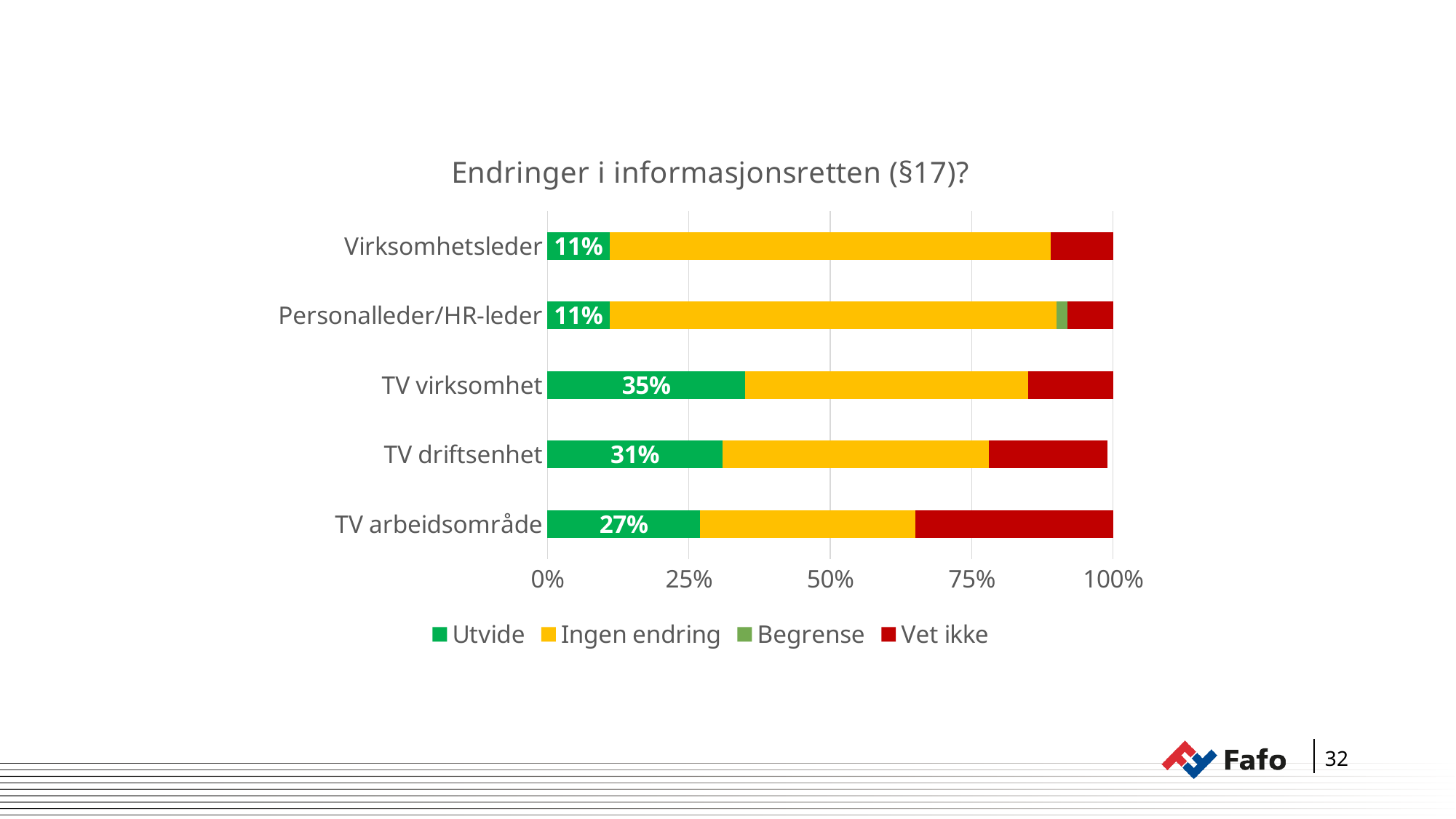
What is the difference between the Utvide values for TV virksomhet and TV arbeidsområde? 8 percentage points What is the Utvide value for TV driftsenhet? 31% What kind of chart is shown on the slide? Stacked bar chart Which has the larger Utvide value, TV driftsenhet or TV arbeidsområde? TV driftsenhet What is the difference between the Utvide values for TV virksomhet and Personalleder/HR-leder? 24 percentage points What is the title of the chart? Endringer i informasjonsretten (§17)? What is the Utvide value for TV virksomhet? 35% Which category has the highest Utvide value? TV virksomhet How many categories are shown on the chart? 5 How many series does the legend list? 4 What is the Utvide value for Virksomhetsleder? 11% What is the Utvide value for TV arbeidsområde? 27%